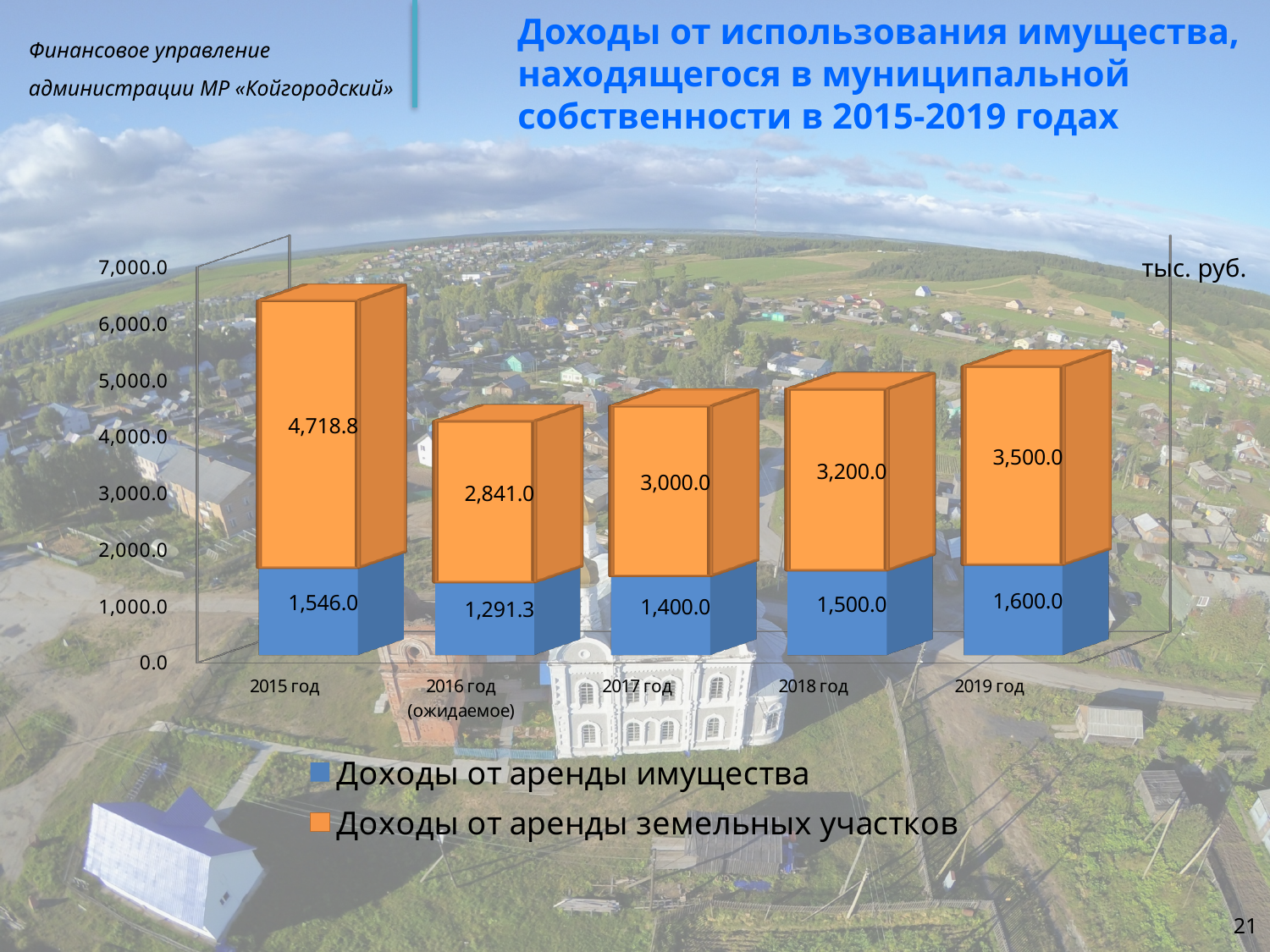
What is the value of 'Доходы от аренды земельных участков' for 2015 год? 4,718.8 What is the value of 'Доходы от аренды имущества' for 2016 год (ожидаемое)? 1,291.3 What is the difference between 'Доходы от аренды земельных участков' in 2019 год and 2018 год? 300.0 What is the total of the stacked bar for 2017 год? 4,400.0 Which is larger: 'Доходы от аренды имущества' in 2015 год or in 2019 год? 2019 год In which year is 'Доходы от аренды земельных участков' the highest? 2015 год What type of chart is shown on the slide? Stacked bar chart Does 'Доходы от аренды имущества' rise or fall from 2016 год (ожидаемое) to 2019 год? Rise What is the value of 'Доходы от аренды земельных участков' for 2019 год? 3,500.0 In which year is 'Доходы от аренды имущества' the lowest? 2016 год (ожидаемое) How many series does the legend list? 2 How many year categories are shown on the x axis? 5